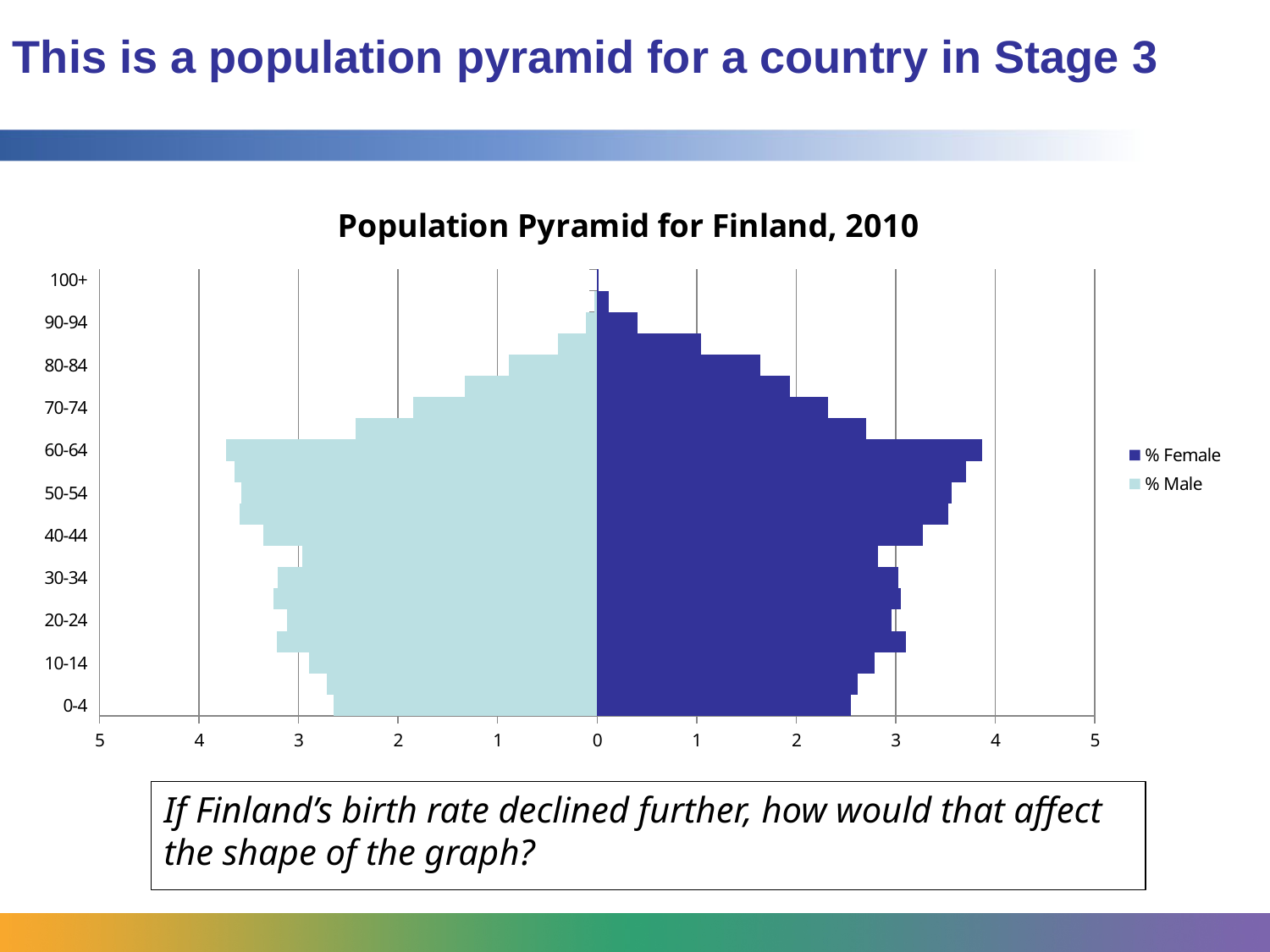
Is the % Female value for the 60-64 age group greater or less than 3? greater Which two series are listed in the legend? % Female and % Male Which age group has the smallest % Female bar? 100+ Is the % Male value for the 0-4 age group greater or less than 2? greater Do the % Female values rise or fall going from the 60-64 age group up to 100+? fall For the 80-84 age group, which is larger, % Female or % Male? % Female How many age-group labels are shown on the vertical axis? 11 What kind of chart is shown on the slide? Bar chart (population pyramid) How many series does the legend list? 2 What is the title of the chart? Population Pyramid for Finland, 2010 Is the % Male value for the 80-84 age group greater or less than 1? less Which age group has the largest % Female bar? 60-64